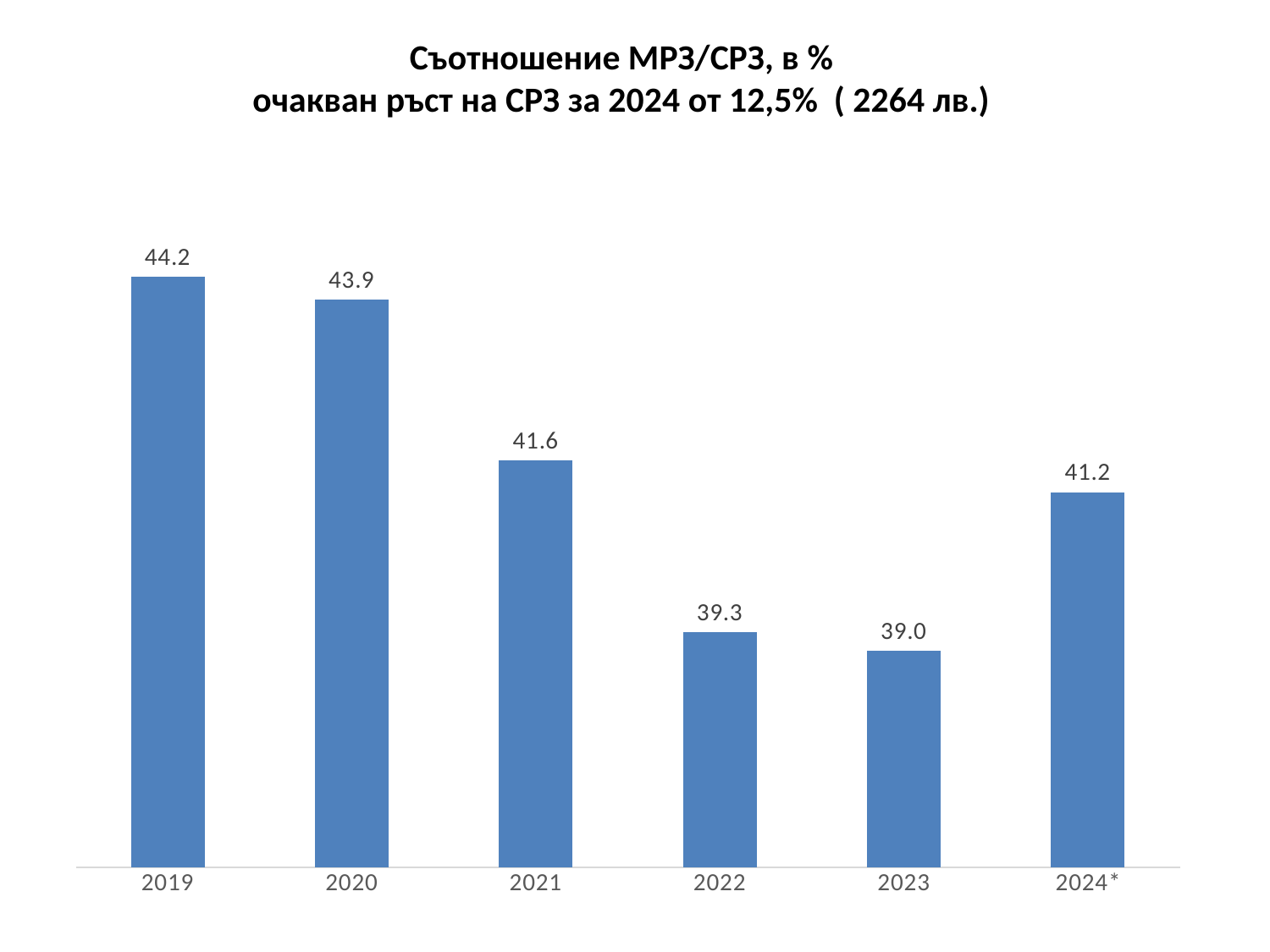
What kind of chart is this? bar chart What is the difference between the values for 2021 and 2022? 2.3 Which is larger, the value for 2021 or the value for 2024*? 2021 Which year has the highest value? 2019 Which year has the lowest value? 2023 What is the value for 2024*? 41.2 What is the value for 2022? 39.3 What is the value for 2019? 44.2 What is the first line of the chart title? Съотношение МРЗ/СРЗ, в % Do the values rise or fall from 2019 to 2023? fall What is the difference between the values for 2019 and 2023? 5.2 How many years are shown on the chart? 6